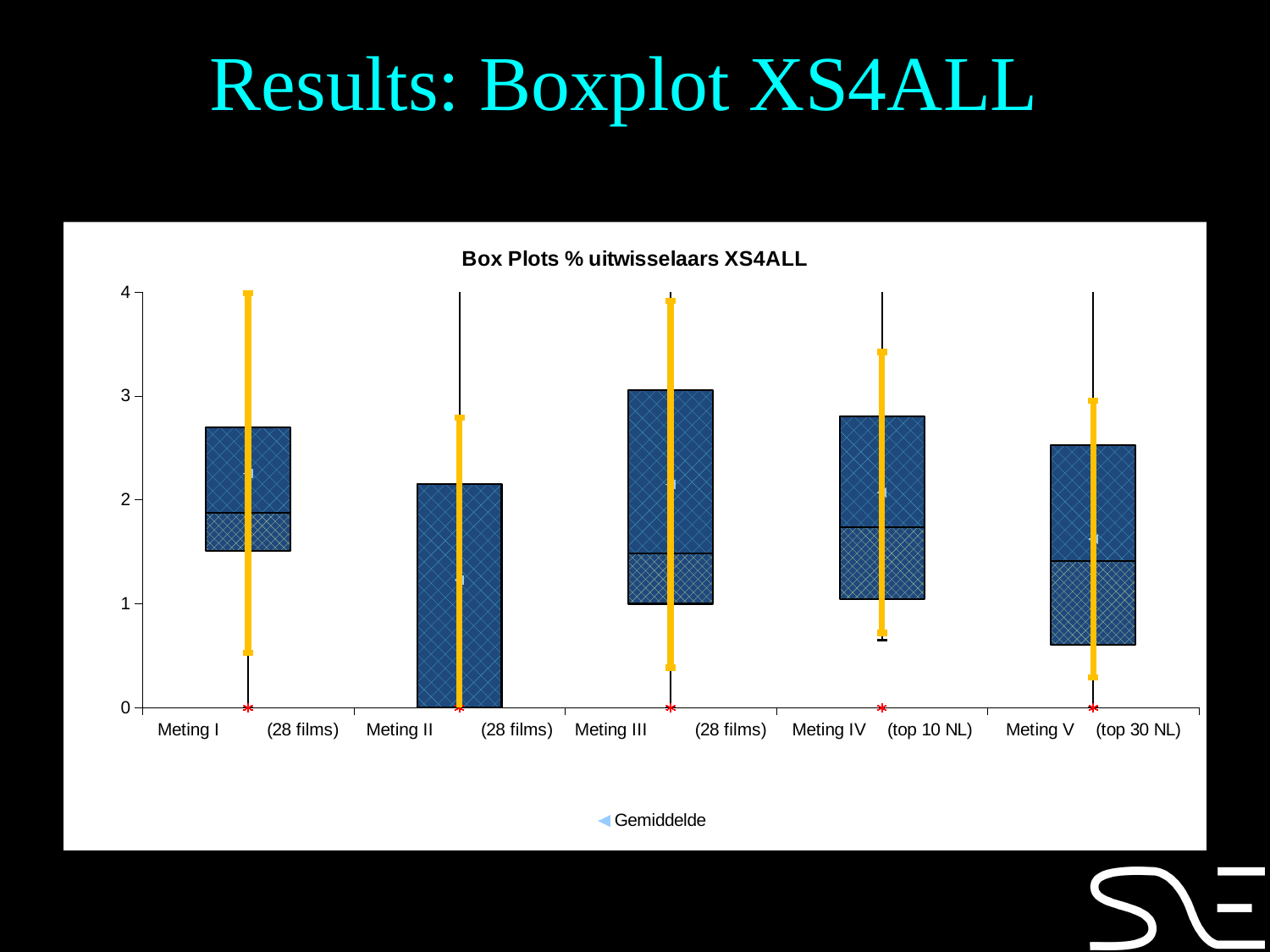
How many categories (metingen) are shown along the x axis? 5 Is the median line for Meting III greater or less than 2? less What is the title of the chart? Box Plots % uitwisselaars XS4ALL Which category has the lowest lower edge of its box? Meting II (28 films) Which has a higher upper box edge, Meting III or Meting IV? Meting III Which category has the highest upper edge of its box? Meting III (28 films) What entry does the legend below the chart list? Gemiddelde What kind of chart is shown on the slide? Box plot Is the upper edge of the box for Meting I greater or less than 3? less Is the lower edge of the box for Meting V greater or less than 1? less Which has a higher lower box edge, Meting I or Meting V? Meting I